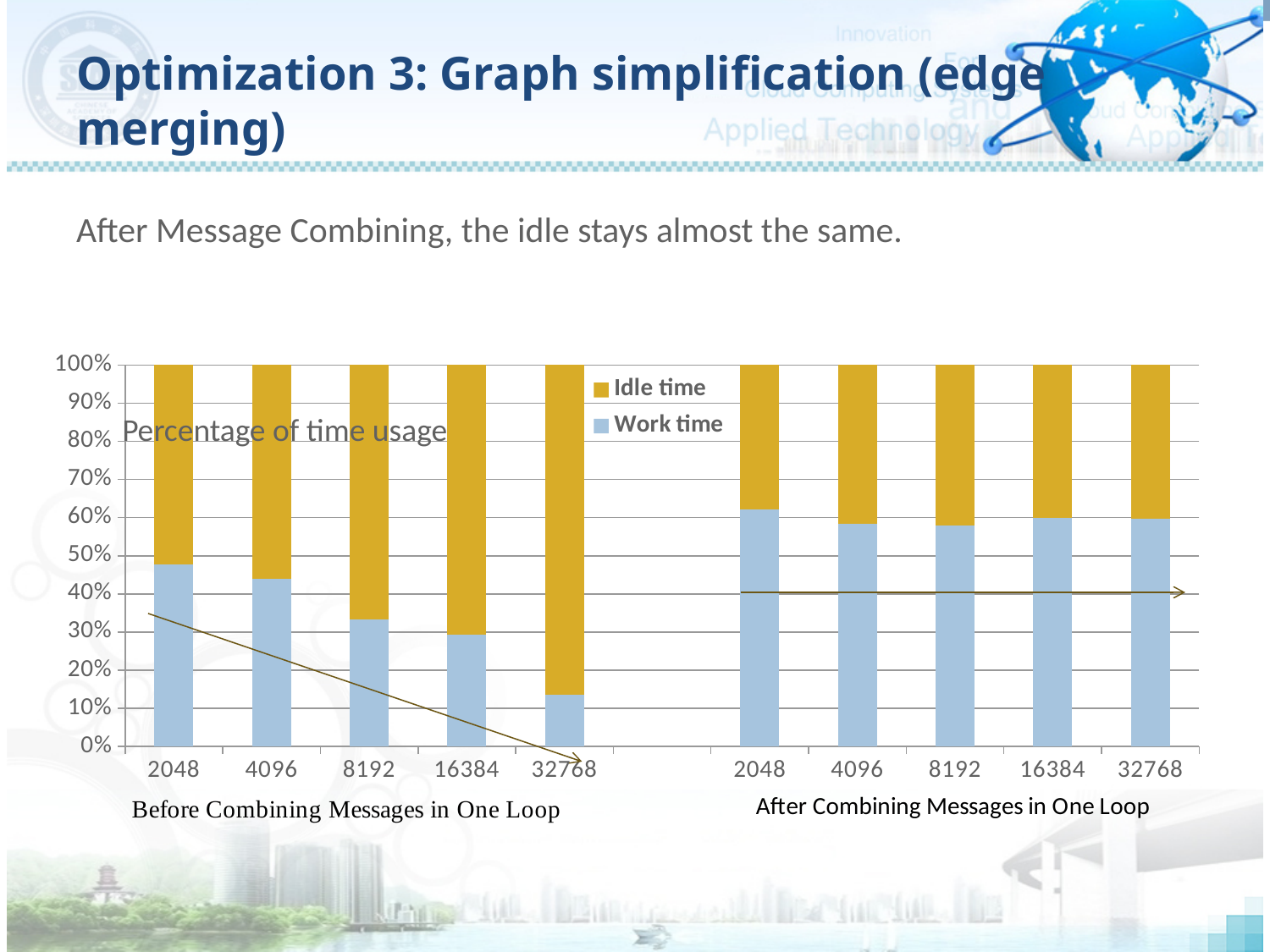
In the 'Before Combining Messages in One Loop' group, which category has the lowest Work time share? 32768 In the 'Before Combining Messages in One Loop' group, which category has the highest Work time share? 2048 What is the title printed on the chart? Percentage of time usage In the 'After Combining Messages in One Loop' group, is the Work time share for 2048 greater or less than 50%? greater How many bars are in the 'Before Combining Messages in One Loop' group? 5 How many series does the legend list? 2 What kind of chart is shown on the slide? stacked bar chart Which has the larger Work time share: 16384 in the 'Before Combining' group or 16384 in the 'After Combining' group? 16384 in the After Combining group How many bars are plotted in total across both groups? 10 In the 'Before Combining Messages in One Loop' group, does the Work time share rise or fall as the x-axis value increases from 2048 to 32768? fall In the 'Before Combining Messages in One Loop' group, is the Work time share for 32768 greater or less than 20%? less What are the two series named in the legend? Idle time and Work time